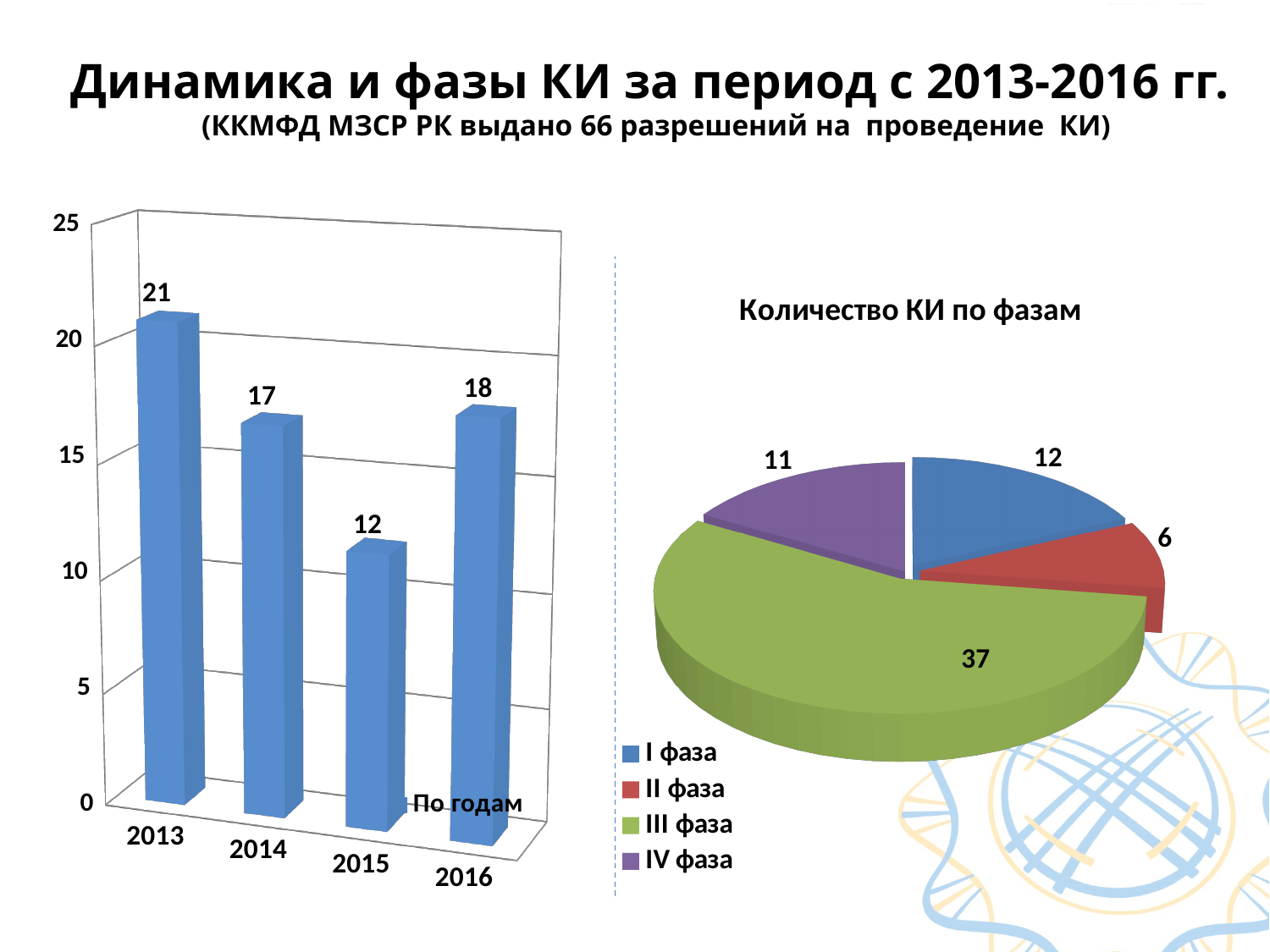
In the bar chart on the left, how many years are shown? 4 What kind of chart is the chart on the left? bar chart In the pie chart 'Количество КИ по фазам', what is the value for III фаза? 37 In the pie chart 'Количество КИ по фазам', what is the difference between the values for I фаза and IV фаза? 1 In the bar chart on the left, which is larger, the value for 2014 or the value for 2016? 2016 In the bar chart on the left, which year has the lowest value? 2015 In the bar chart on the left, what is the value for 2015? 12 In the bar chart on the left, what is the difference between the values for 2013 and 2015? 9 How many entries does the legend of the pie chart 'Количество КИ по фазам' list? 4 In the bar chart on the left, what is the value for 2013? 21 In the pie chart 'Количество КИ по фазам', which phase has the smallest slice? II фаза In the bar chart on the left, which year has the highest value? 2013